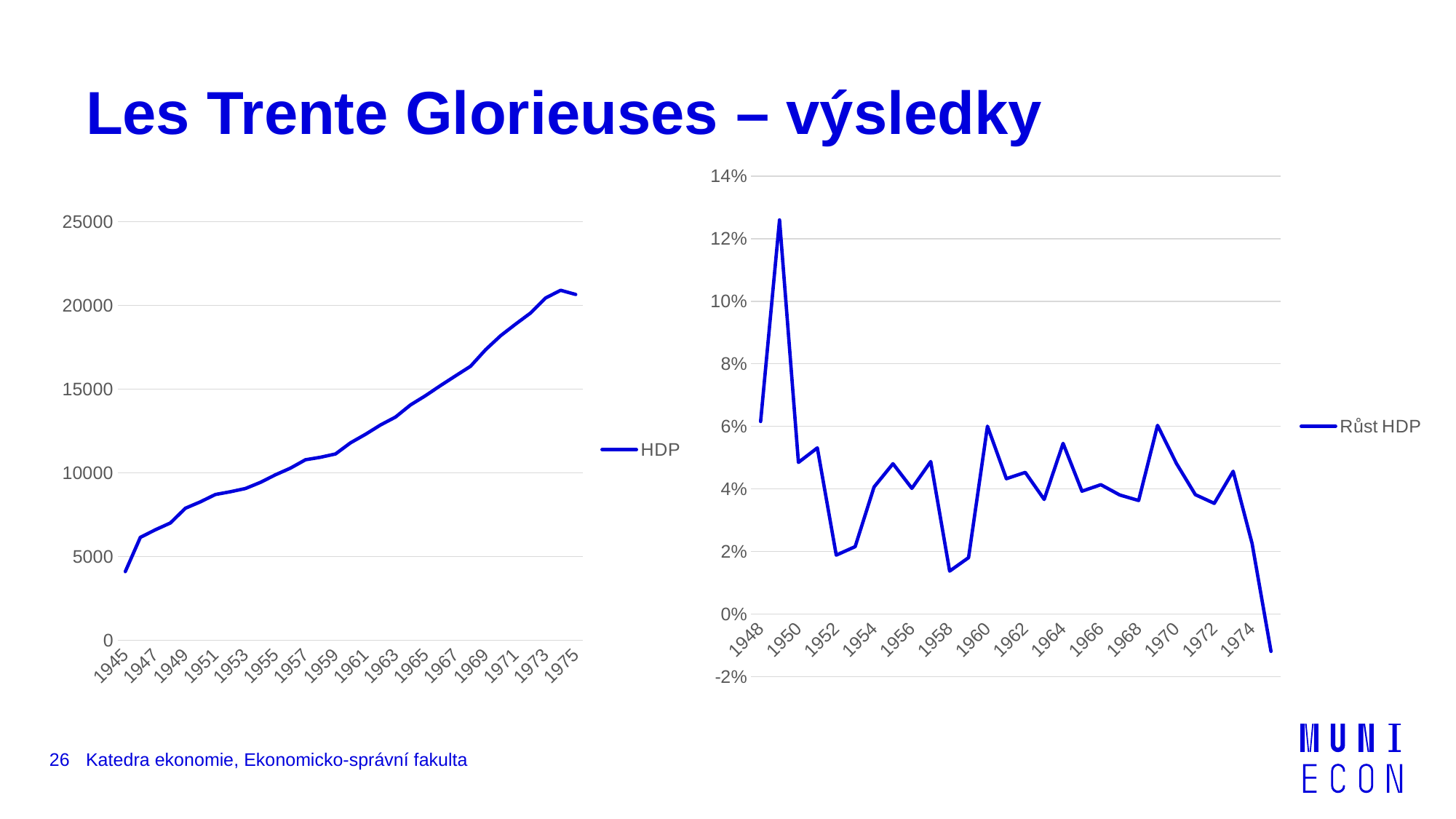
How many series does the legend of the left chart list? 1 In the right chart (Růst HDP), is the value for 1975 greater or less than 0%? less In the left chart (HDP), is the value for 1975 greater or less than 20000? greater In the right chart (Růst HDP), is the value for 1958 greater or less than 2%? less In the right chart (Růst HDP), which year has the highest value? 1949 What is the legend entry of the right chart? Růst HDP What kind of chart is the right chart (Růst HDP)? line chart In the left chart (HDP), do the values generally rise or fall from 1945 to 1975? rise What kind of chart is the left chart (HDP)? line chart In the right chart (Růst HDP), which year has the lowest value? 1975